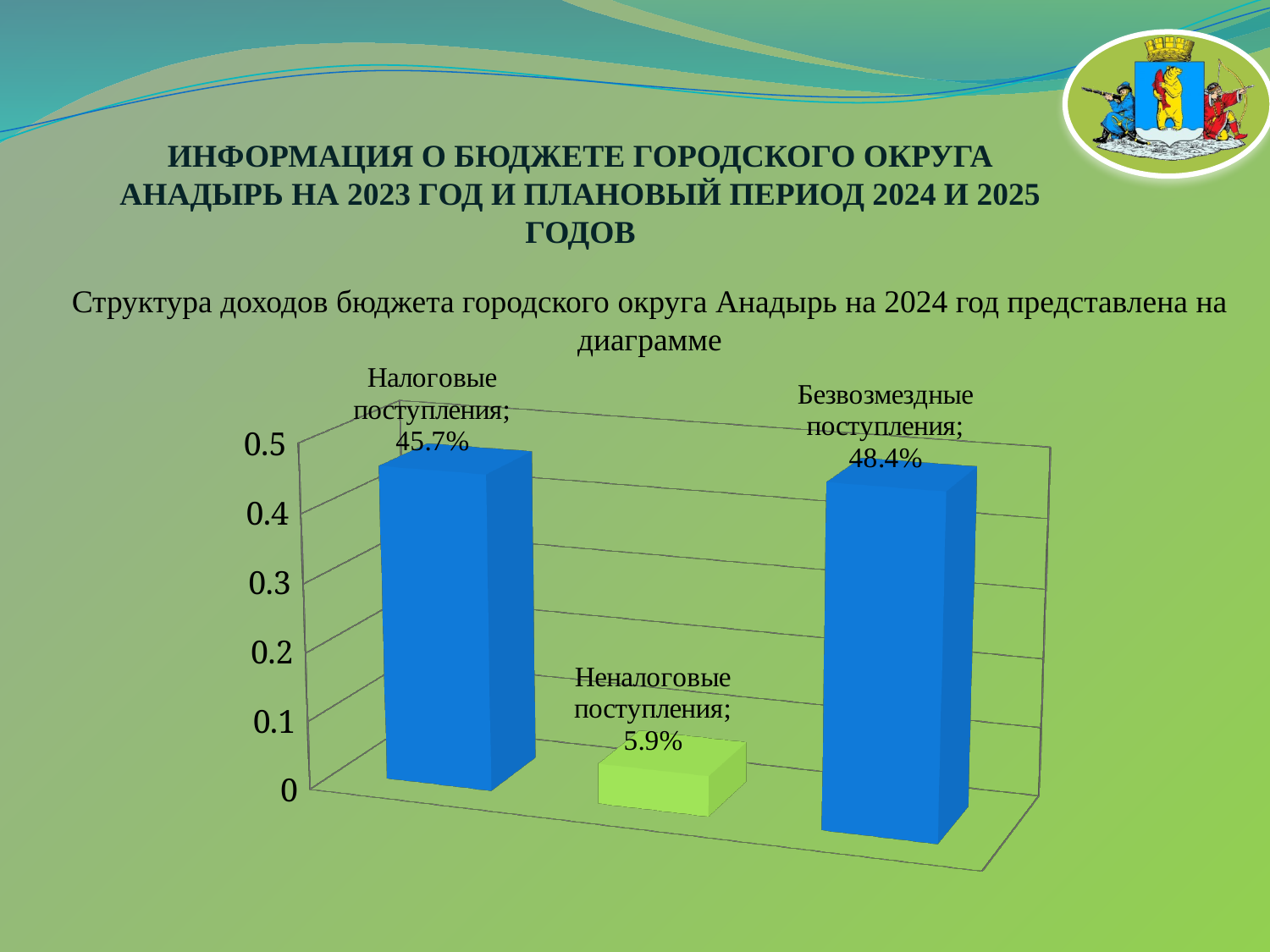
What is the highest tick value shown on the vertical axis? 0.5 What is the difference between Безвозмездные поступления and Налоговые поступления? 2.7% Which category has the highest value? Безвозмездные поступления What is the value for Безвозмездные поступления? 48.4% What is the difference between Налоговые поступления and Неналоговые поступления? 39.8% How many categories are shown in the chart? 3 What is the value for Налоговые поступления? 45.7% Is the value for Неналоговые поступления greater or less than 0.1? less Which is larger, Налоговые поступления or Неналоговые поступления? Налоговые поступления What is the value for Неналоговые поступления? 5.9% Which category has the lowest value? Неналоговые поступления What kind of chart is shown on the slide? bar chart